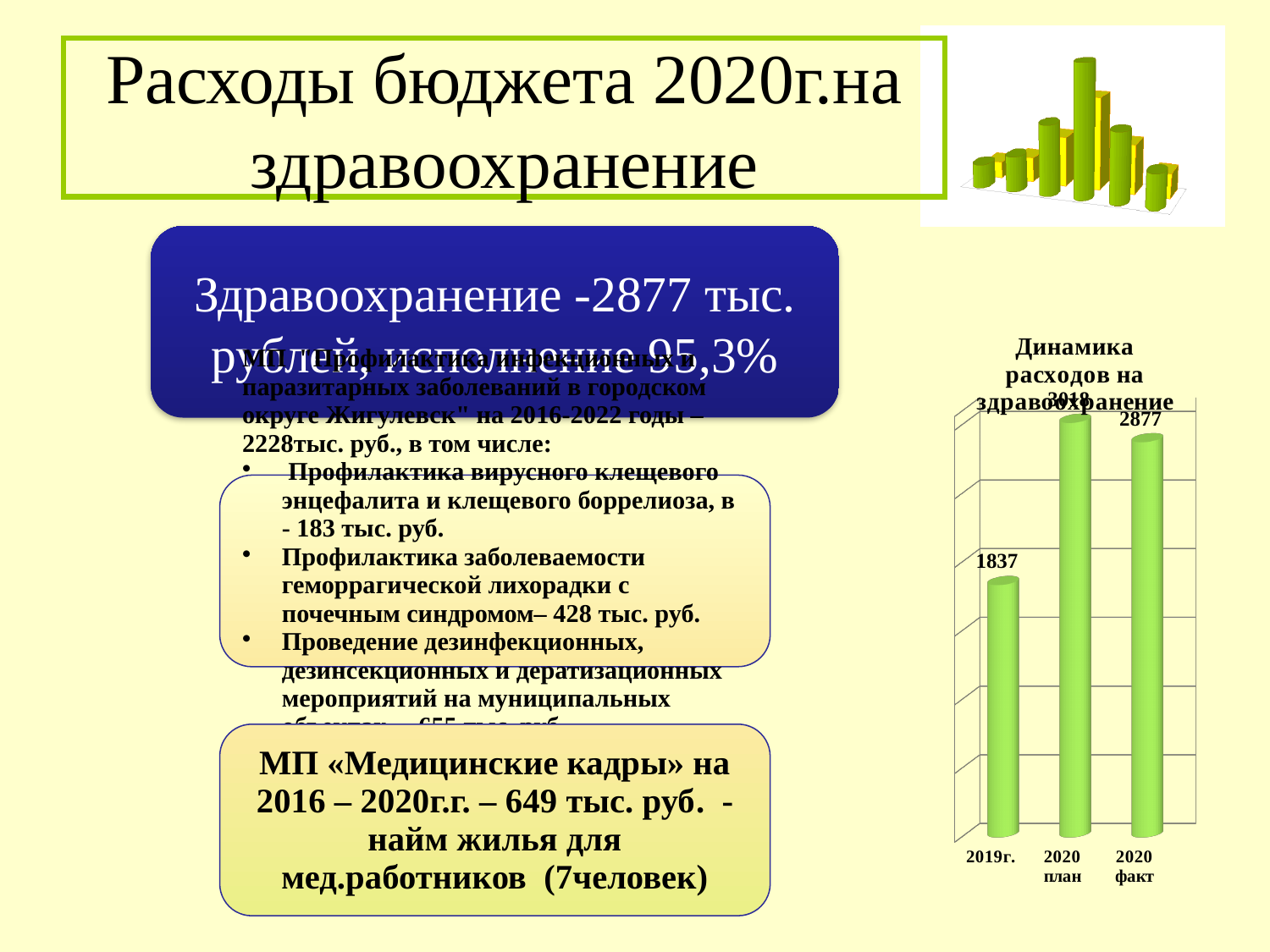
In the chart 'Динамика расходов на здравоохранение', which bar is taller: 2020 план or 2020 факт? 2020 план In the chart 'Динамика расходов на здравоохранение', which is larger: the value for 2019г. or the value for 2020 факт? 2020 факт What is the value for 2020 факт in the chart 'Динамика расходов на здравоохранение'? 2877 Which category has the lowest value in the chart 'Динамика расходов на здравоохранение'? 2019г. How many categories are shown in the chart 'Динамика расходов на здравоохранение'? 3 What is the title of the chart on the right side of the slide? Динамика расходов на здравоохранение What is the value for 2019г. in the chart 'Динамика расходов на здравоохранение'? 1837 In the chart 'Динамика расходов на здравоохранение', does the value rise or fall from 2020 план to 2020 факт? fall What kind of chart is 'Динамика расходов на здравоохранение'? bar chart In the chart 'Динамика расходов на здравоохранение', what is the difference between the 2020 факт value and the 2019г. value? 1040 In the chart 'Динамика расходов на здравоохранение', does the value rise or fall from 2019г. to 2020 план? rise Which category has the highest bar in the chart 'Динамика расходов на здравоохранение'? 2020 план